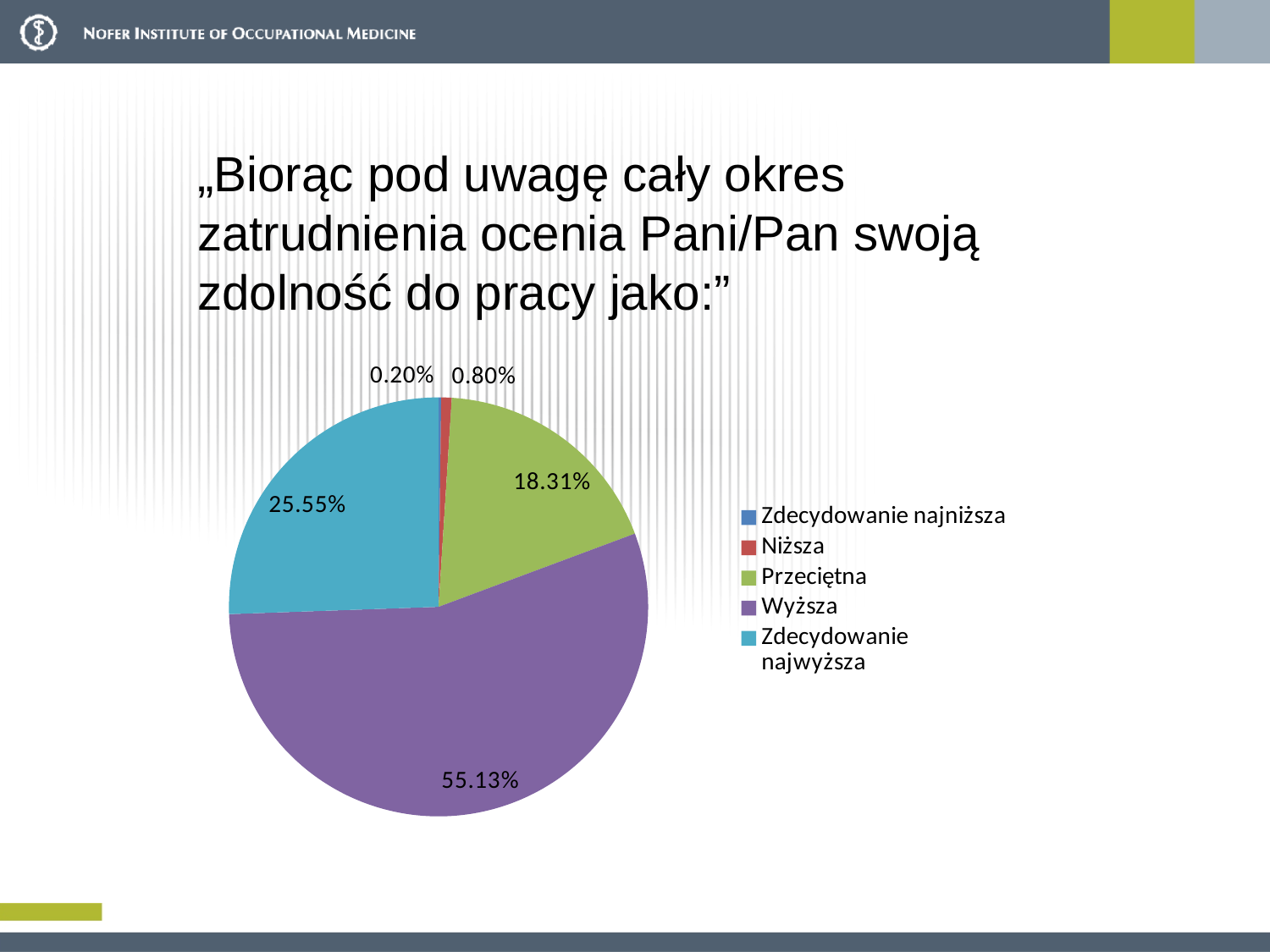
Which is larger, the value for "Przeciętna" or the value for "Zdecydowanie najwyższa"? Zdecydowanie najwyższa What is the value shown for "Przeciętna"? 18.31% How many categories does the legend list? 5 Which category has the largest slice of the pie? Wyższa What kind of chart is shown on the slide? Pie chart What share of the pie does the "Wyższa" slice represent? 55.13% What is the value shown for "Zdecydowanie najwyższa"? 25.55% What is the value shown for "Zdecydowanie najniższa"? 0.20% What colour is the "Wyższa" slice in the pie chart? Purple What is the difference between the values for "Wyższa" and "Zdecydowanie najwyższa"? 29.58% What is the value shown for "Niższa"? 0.80% Which category has the smallest slice of the pie? Zdecydowanie najniższa